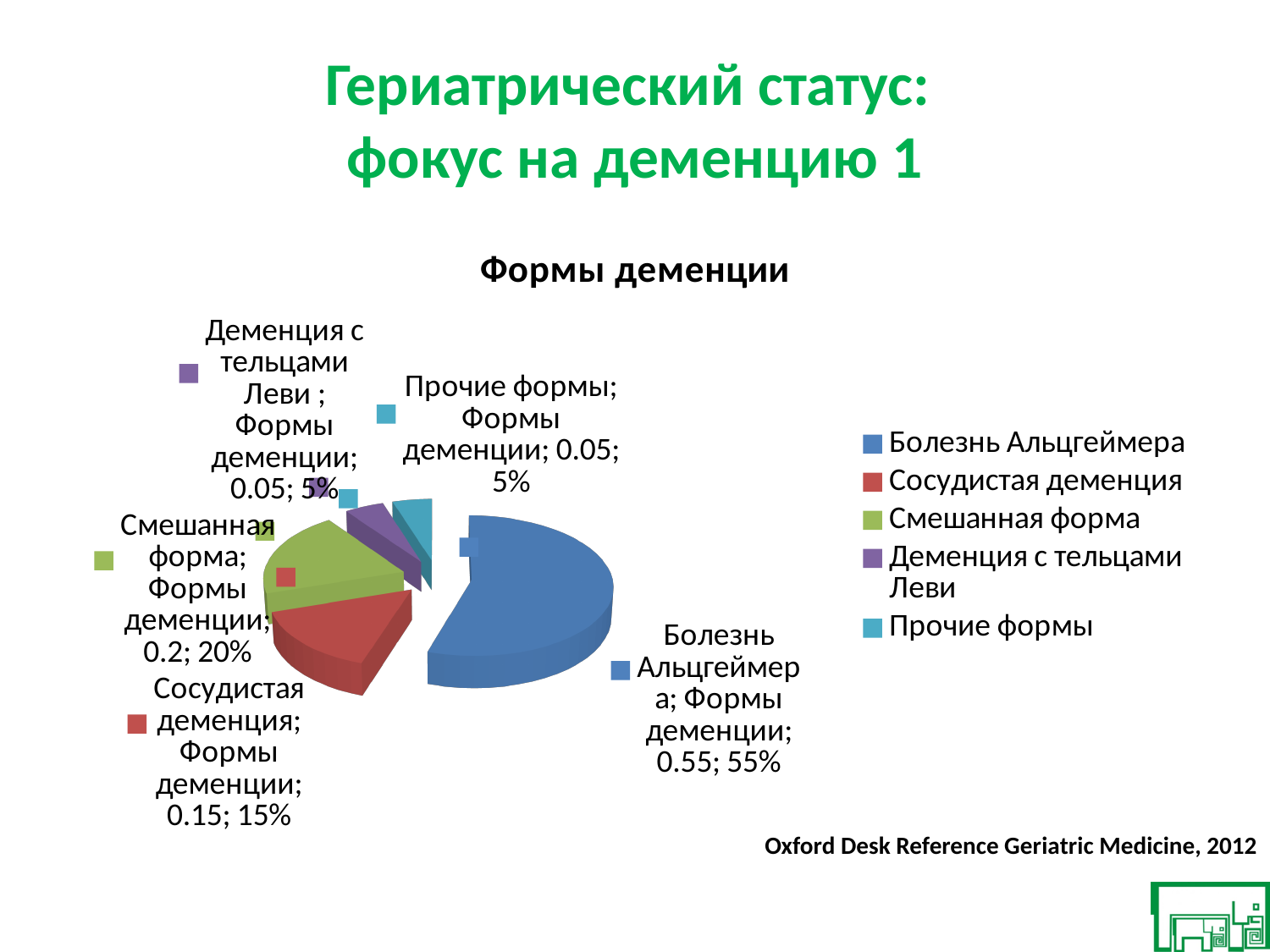
What type of chart is shown on the slide? Pie chart What is the difference in percentage points between Болезнь Альцгеймера and Смешанная форма? 35% What is the title of the chart? Формы деменции Which category has the largest slice of the pie? Болезнь Альцгеймера Which is larger, Смешанная форма or Сосудистая деменция? Смешанная форма How many slices does the pie chart have? 5 What is the difference in percentage points between Сосудистая деменция and Прочие формы? 10% What percentage share does Смешанная форма have in the pie chart? 20% How many entries does the legend list? 5 What value is shown for Деменция с тельцами Леви? 0.05 What percentage share does Сосудистая деменция have in the pie chart? 15% What percentage share does Болезнь Альцгеймера have in the pie chart? 55%